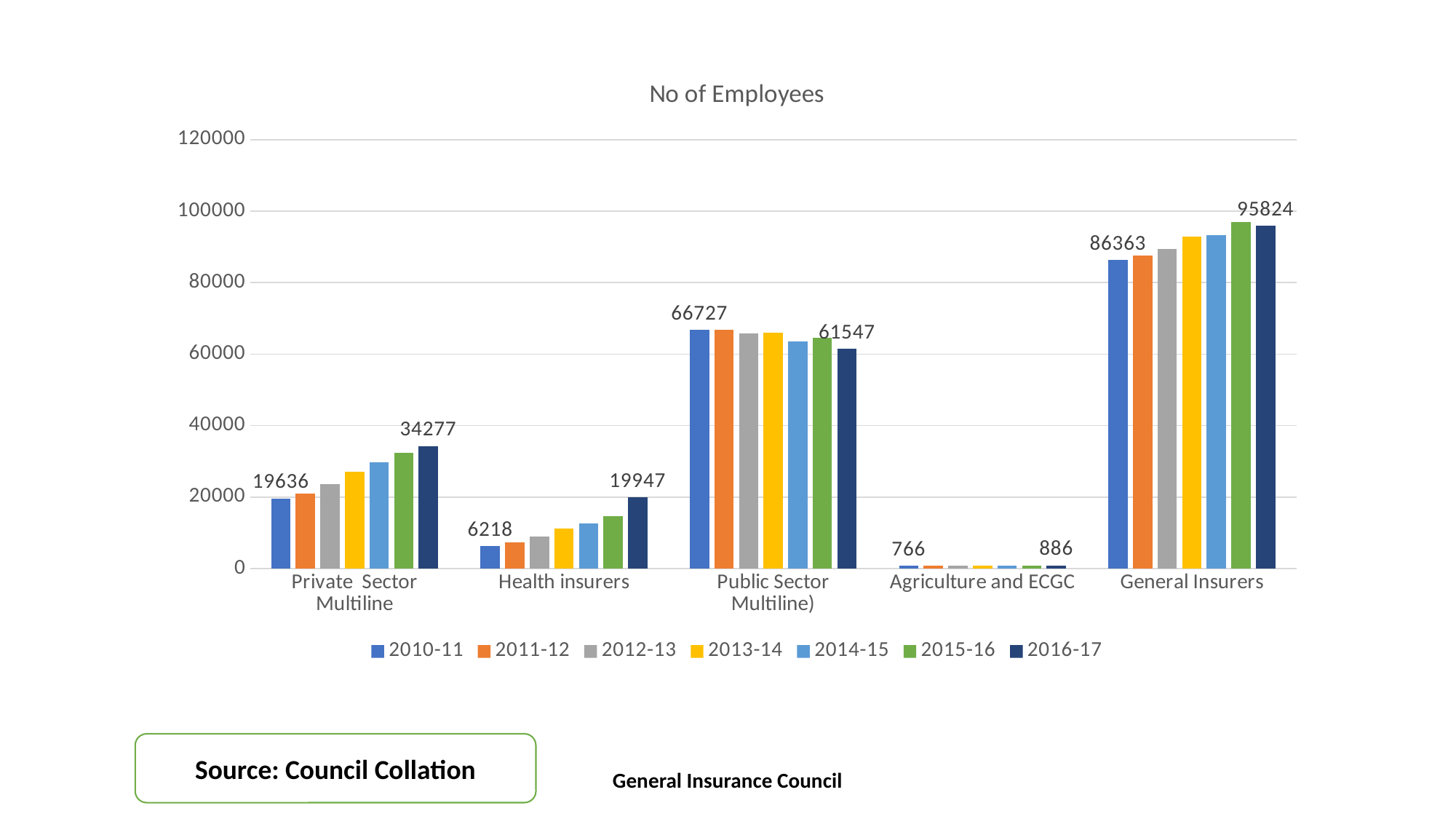
Do the Private Sector Multiline values rise or fall from 2010-11 to 2016-17? Rise Which category has the highest number of employees in 2016-17? General Insurers How many series does the legend list? 7 Which is larger: the Private Sector Multiline value in 2016-17 or the Health insurers value in 2016-17? Private Sector Multiline What is the number of employees for General Insurers in 2016-17? 95824 Which category has the lowest number of employees in 2010-11? Agriculture and ECGC What is the number of employees for Private Sector Multiline in 2010-11? 19636 What is the difference between the Public Sector Multiline employee count in 2010-11 and in 2016-17? 5180 What kind of chart is shown on the slide? Bar chart What is the number of employees for Health insurers in 2010-11? 6218 What is the number of employees for Agriculture and ECGC in 2016-17? 886 Is the value for Public Sector Multiline in 2013-14 greater or less than 60000? greater